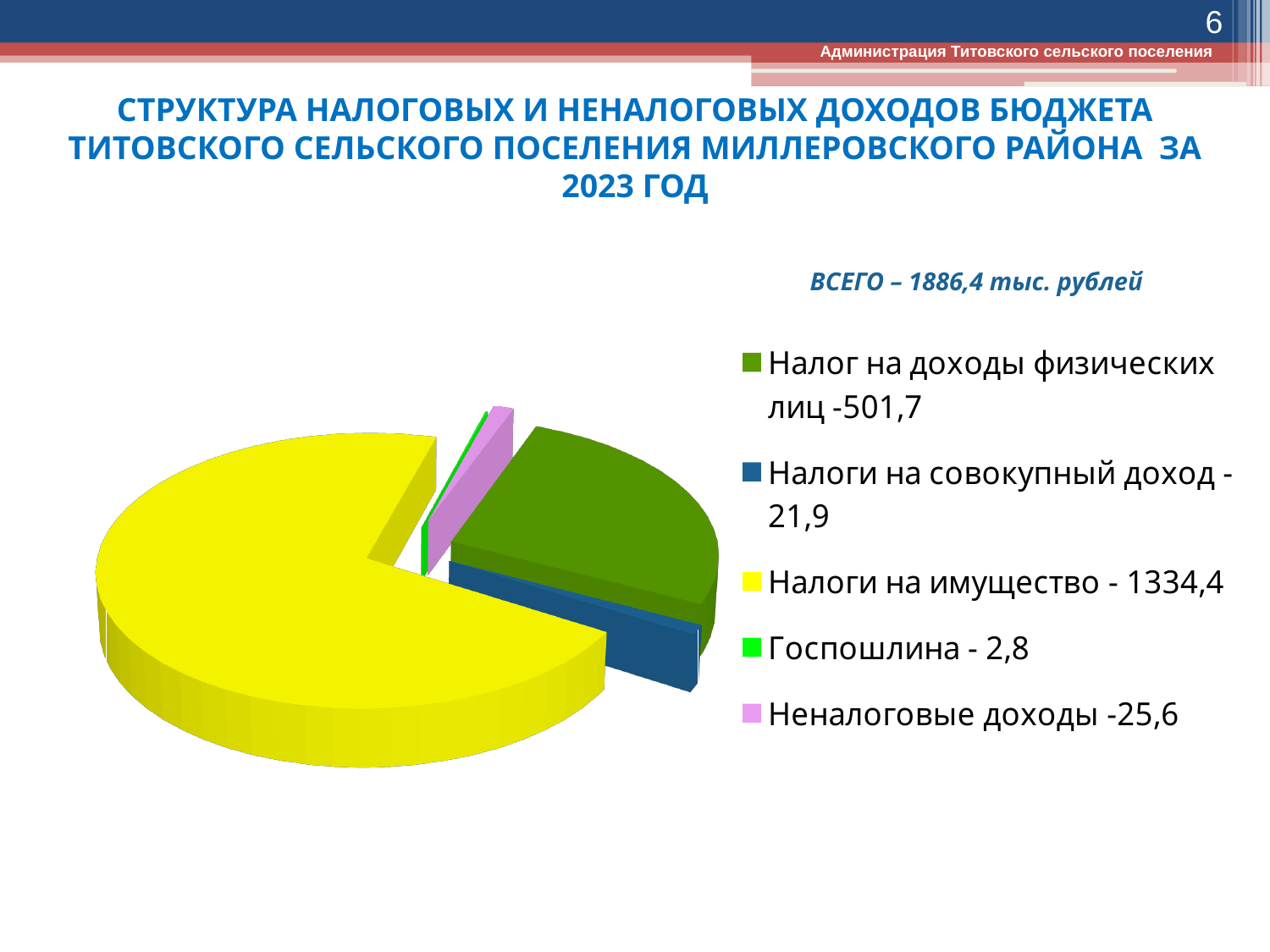
What is the value for Налоги на совокупный доход? 21,9 What total (ВСЕГО) is stated on the slide for the chart? 1886,4 тыс. рублей What is the value for Госпошлина? 2,8 What is the value for Налоги на имущество? 1334,4 Which is larger: Неналоговые доходы or Налоги на совокупный доход? Неналоговые доходы Which category has the smallest slice of the pie? Госпошлина What is the difference between Налоги на имущество and Налог на доходы физических лиц? 832,7 What is the value for Неналоговые доходы? 25,6 Which category has the largest slice of the pie? Налоги на имущество What is the value for Налог на доходы физических лиц? 501,7 What kind of chart is shown on the slide? Pie chart How many categories does the pie chart show? 5